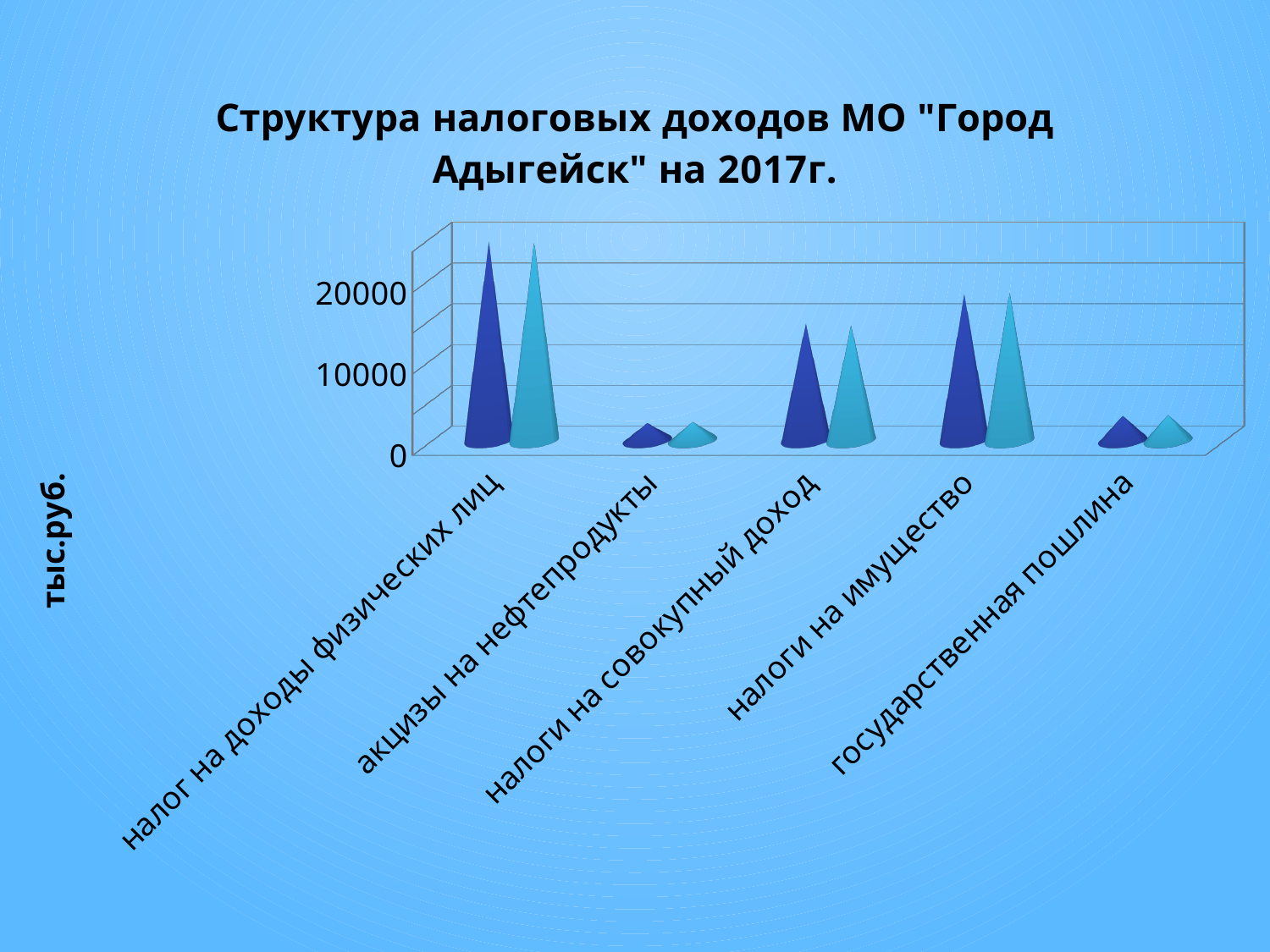
Which is larger, the value for налоги на имущество or the value for налоги на совокупный доход? налоги на имущество Is the value for государственная пошлина greater or less than 10000? less How many categories are shown on the x axis of the chart? 5 What unit label is shown on the vertical axis of the chart? тыс.руб. Is the value for налоги на совокупный доход greater or less than 10000? greater Is the value for налог на доходы физических лиц greater or less than 20000? greater What is the title of the chart? Структура налоговых доходов МО "Город Адыгейск" на 2017г. What kind of chart is shown on the slide? bar chart Which category has the highest value in the chart? налог на доходы физических лиц Which is larger, the value for налог на доходы физических лиц or the value for налоги на имущество? налог на доходы физических лиц